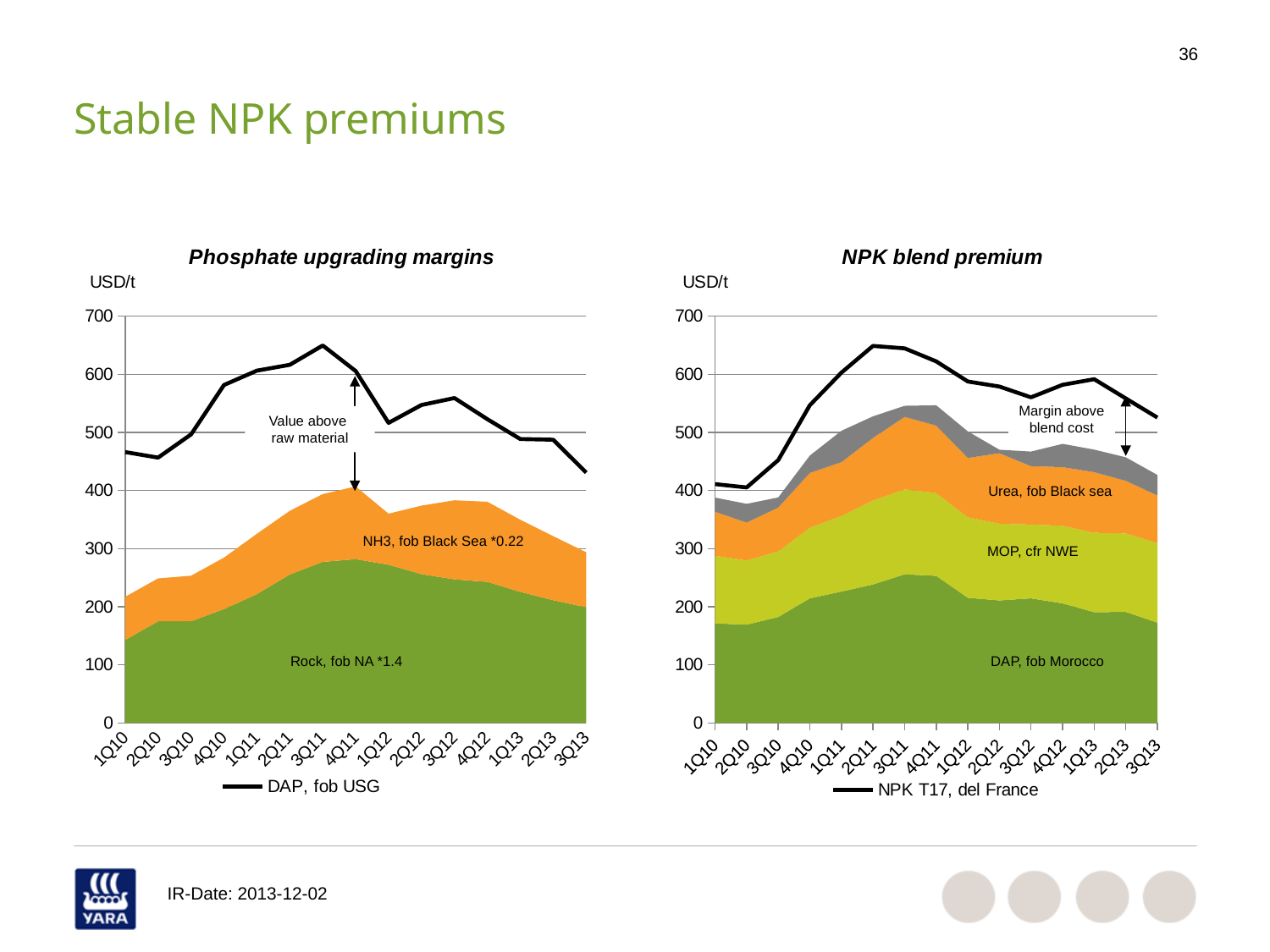
In the 'Phosphate upgrading margins' chart, is the DAP, fob USG value in 3Q11 greater or less than 600? greater In the 'Phosphate upgrading margins' chart, what is the label of the bottom (green) area? Rock, fob NA *1.4 In the 'NPK blend premium' chart, what unit is shown on the y axis? USD/t In the 'Phosphate upgrading margins' chart, is the DAP, fob USG value larger in 4Q10 or in 1Q12? 4Q10 In the 'Phosphate upgrading margins' chart, in which quarter does the DAP, fob USG line reach its highest value? 3Q11 What kind of chart is the 'Phosphate upgrading margins' chart? Stacked area chart with a line In the 'Phosphate upgrading margins' chart, is the DAP, fob USG value in 3Q13 greater or less than 500? less In the 'Phosphate upgrading margins' chart, does the DAP, fob USG line rise or fall from 3Q11 to 3Q13? Fall In the 'NPK blend premium' chart, does the NPK T17, del France line rise or fall from 1Q10 to 2Q11? Rise In the 'Phosphate upgrading margins' chart, how many quarters are shown on the x axis? 15 In the 'NPK blend premium' chart, is the NPK T17, del France value in 1Q10 greater or less than 500? less